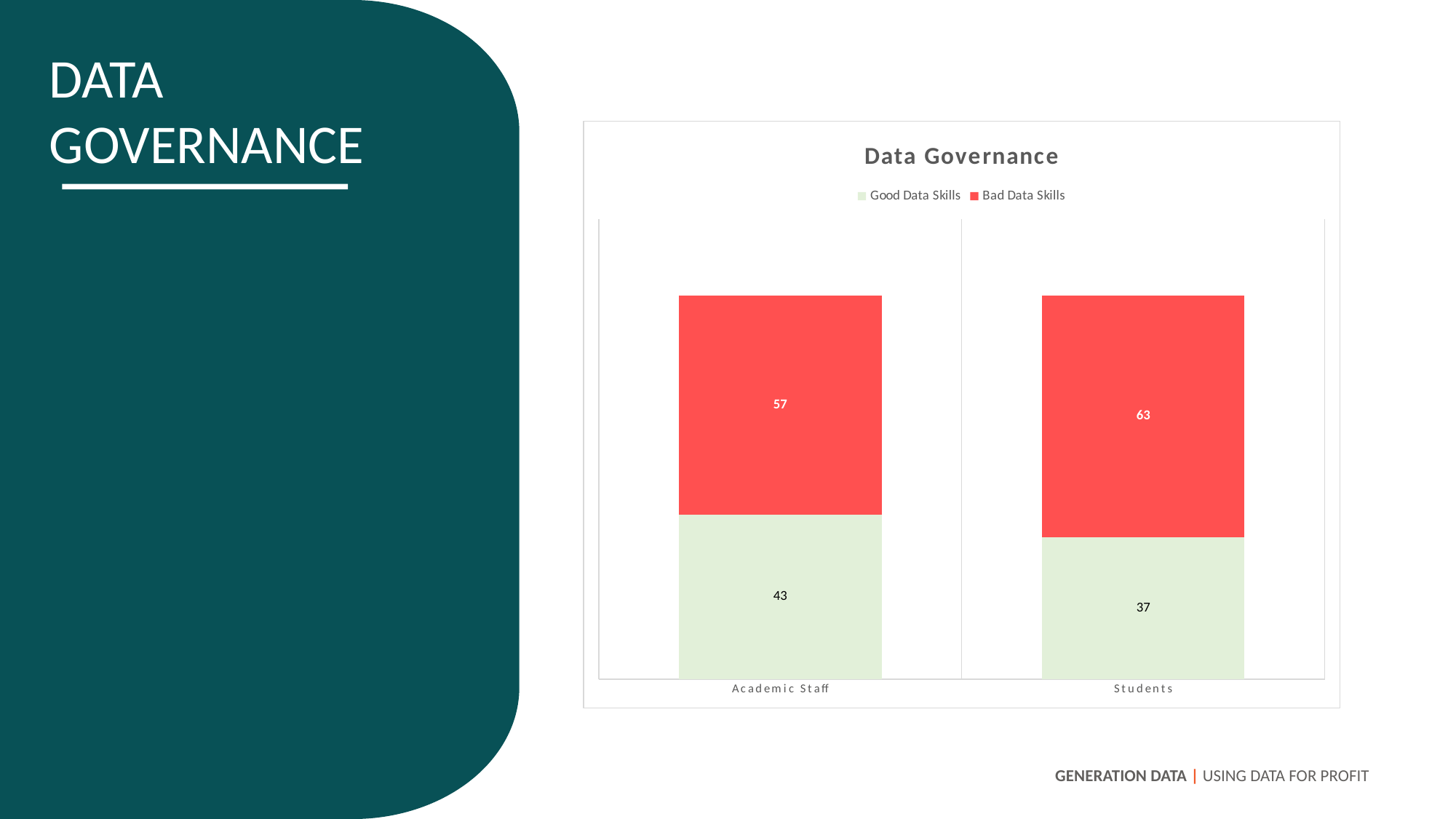
What is the Bad Data Skills value for Students? 63 Which category has the higher Bad Data Skills value? Students How many series does the legend list? 2 What is the Bad Data Skills value for Academic Staff? 57 What is the Good Data Skills value for Academic Staff? 43 What is the Good Data Skills value for Students? 37 What is the difference between the Bad Data Skills values for Students and Academic Staff? 6 How many categories are shown on the x axis? 2 Which category has the lower Good Data Skills value? Students What is the total of the stacked bar for Academic Staff? 100 What type of chart is shown? Stacked bar chart Is the Good Data Skills value larger for Academic Staff or for Students? Academic Staff